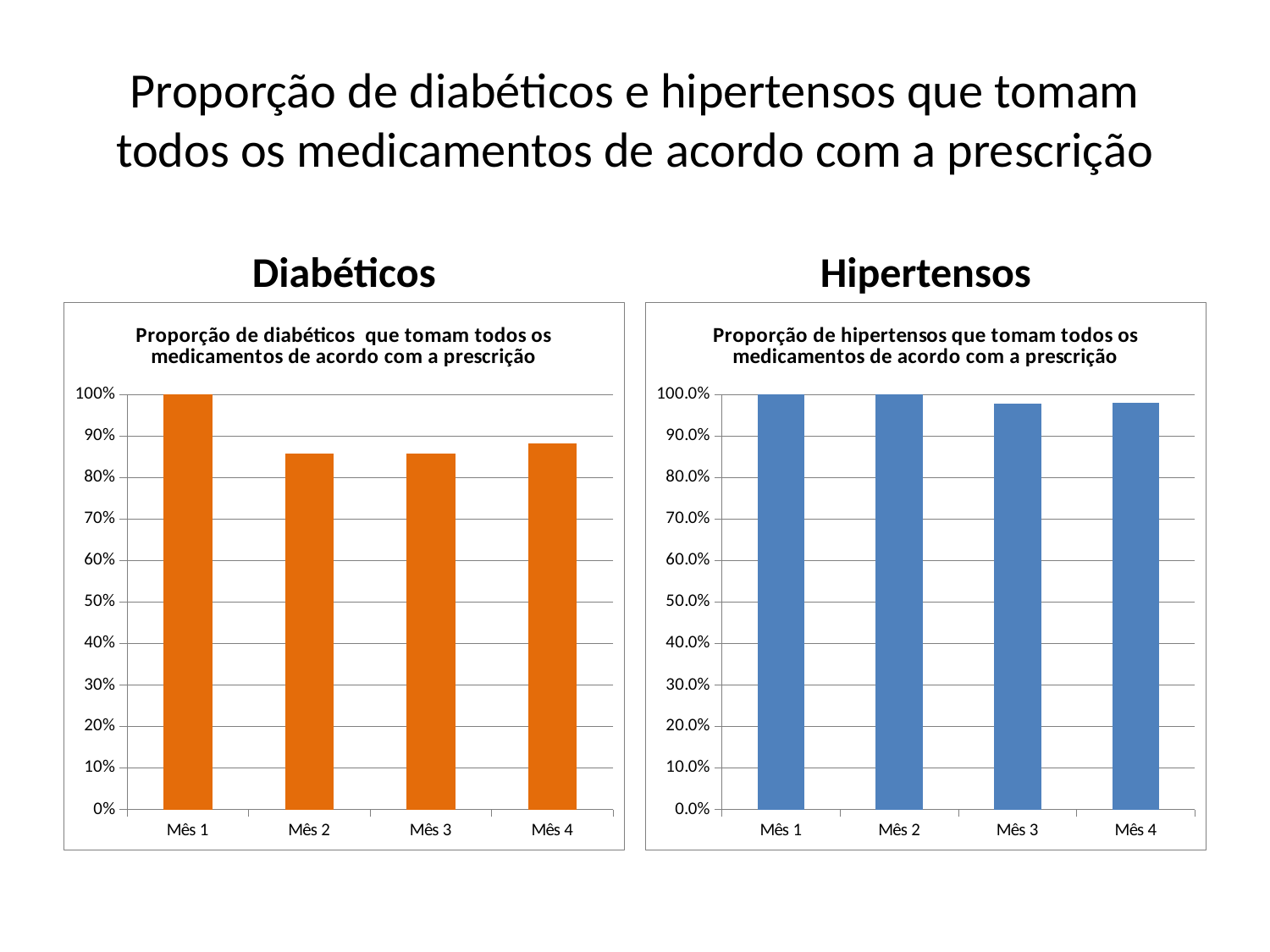
In the Diabéticos chart, does the value rise or fall from Mês 1 to Mês 2? fall In the Diabéticos chart, is the value for Mês 2 greater or less than 90%? less What colour are the bars in the Diabéticos chart? orange In the Diabéticos chart, is the value for Mês 4 greater or less than 80%? greater In the Hipertensos chart, is the value for Mês 3 greater or less than 90.0%? greater In the Diabéticos chart, which is larger, the value for Mês 1 or the value for Mês 4? Mês 1 In the Hipertensos chart, what is the value for Mês 1? 100.0% In the Diabéticos chart, what is the value for Mês 1? 100% What kind of chart is the Diabéticos chart? bar chart In the Diabéticos chart, which month has the highest value? Mês 1 How many months are shown on the x axis of the Hipertensos chart? 4 What colour are the bars in the Hipertensos chart? blue